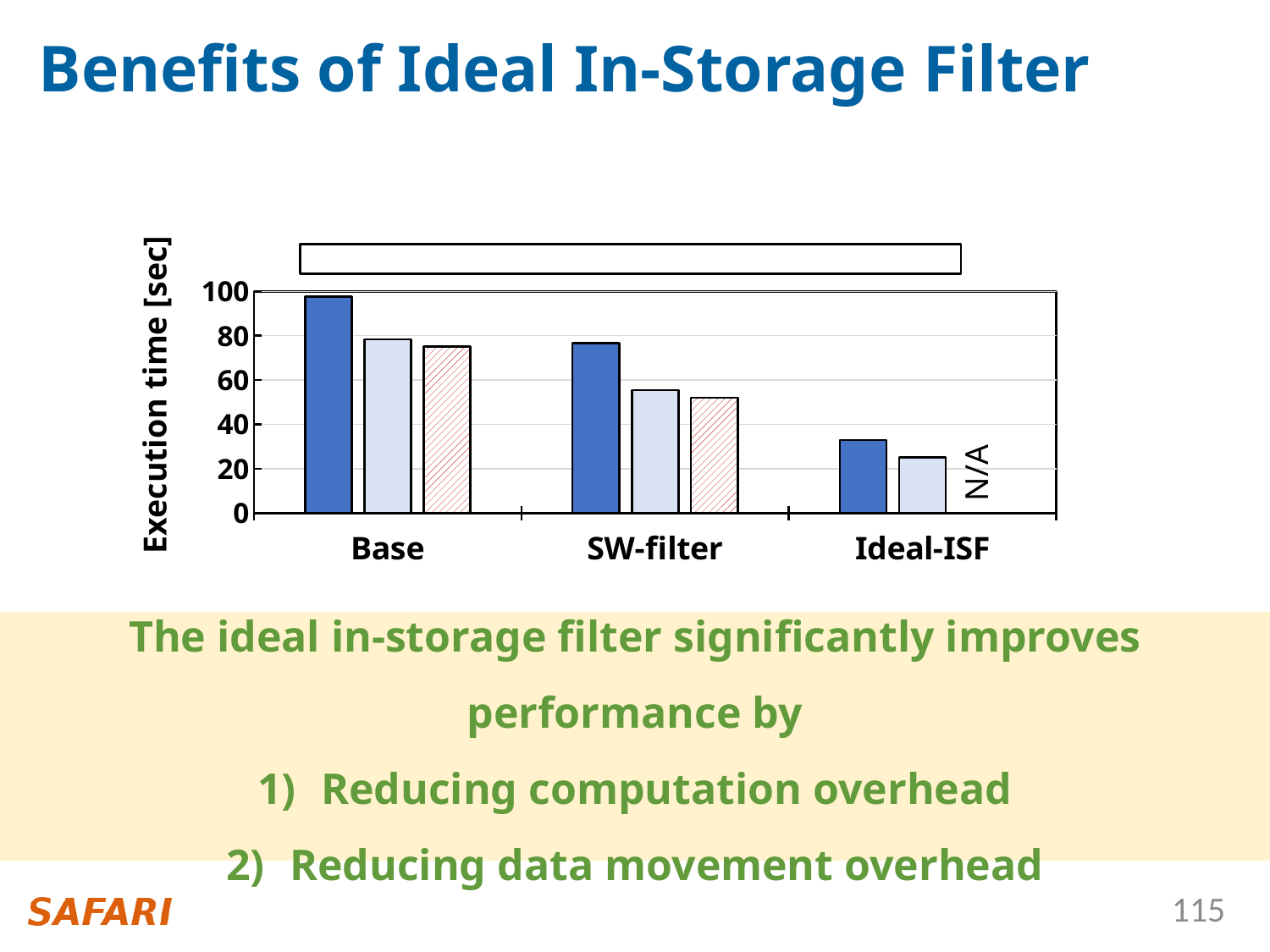
How many categories are shown on the x axis of the chart? 3 Is the red hatched bar for SW-filter greater or less than 60? less What kind of chart is shown on the slide? bar chart Which category shows N/A in place of its third bar? Ideal-ISF Which category has the shortest dark blue bar? Ideal-ISF Do the dark blue bars rise or fall from Base to Ideal-ISF along the x axis? fall Is the dark blue bar for Base greater or less than 80? greater Which category has the tallest dark blue bar? Base Which is larger, the dark blue bar for SW-filter or the dark blue bar for Ideal-ISF? SW-filter Is the dark blue bar for Ideal-ISF greater or less than 40? less What is the label of the y axis of the chart? Execution time [sec]